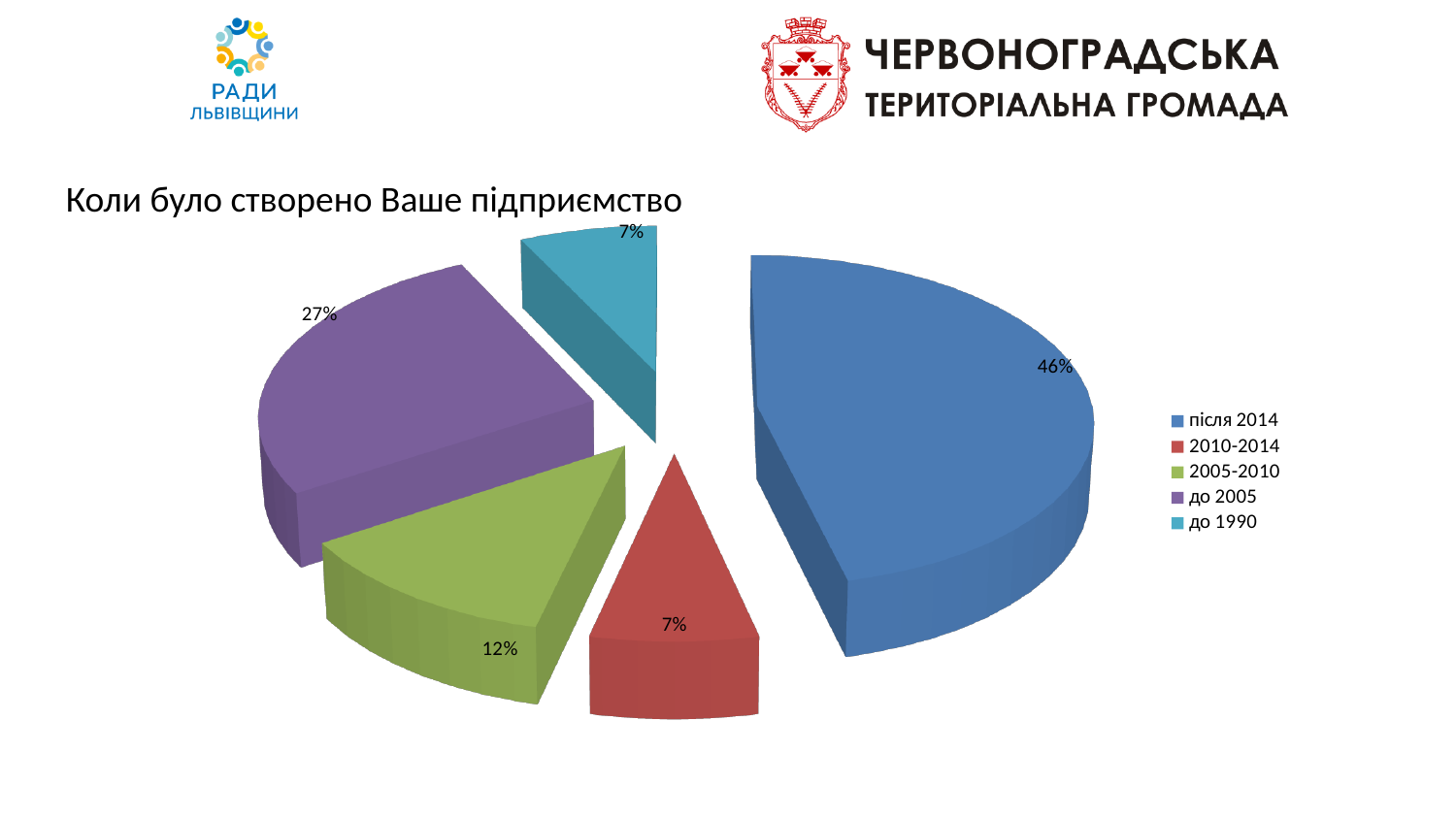
What colour is the 'до 2005' slice? purple What share of the pie does the 'до 2005' slice represent? 27% What share of the pie does the '2010-2014' slice represent? 7% How many categories does the legend list? 5 What share of the pie does the 'після 2014' slice represent? 46% Which slice is larger, '2005-2010' or 'до 2005'? до 2005 What is the difference in percentage points between the 'після 2014' slice and the 'до 2005' slice? 19 What kind of chart is shown on the slide? pie chart What is the title of the chart? Коли було створено Ваше підприємство Which category has the largest slice of the pie? після 2014